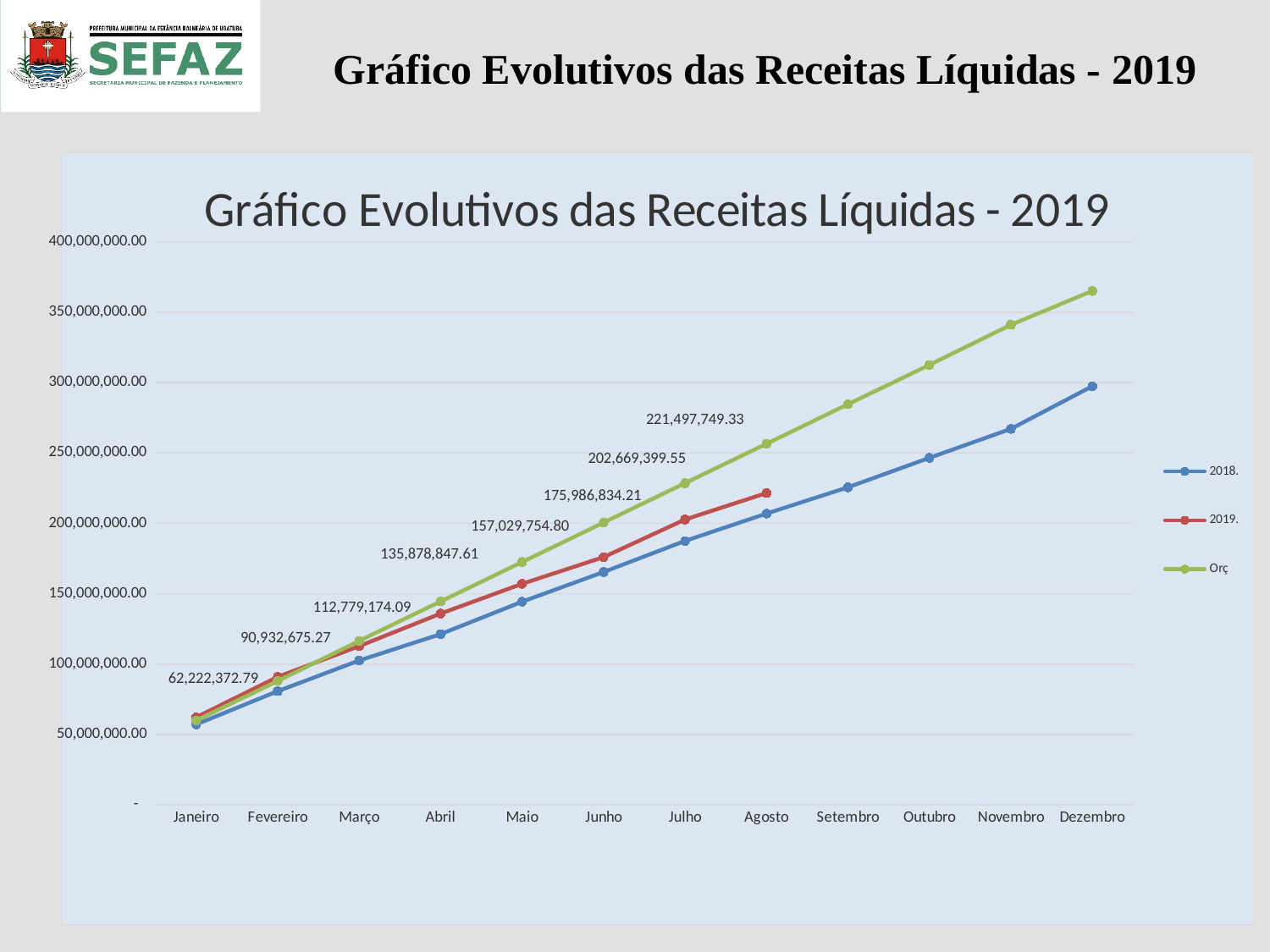
What is the value of the 2019. series for Agosto? 221,497,749.33 Which series has the higher value in Dezembro, 2018. or Orç? Orç What is the value of the 2019. series for Junho? 175,986,834.21 What is the difference between the 2019. values for Fevereiro and Janeiro? 28,710,302.48 How many series does the legend list? 3 Is the value of the Orç series for Dezembro greater or less than 350,000,000.00? greater What type of chart is shown on the slide? Line chart What is the difference between the 2019. values for Agosto and Julho? 18,828,349.78 In which month does the 2019. series reach its highest value? Agosto How many months are shown on the x axis? 12 What is the value of the 2019. series for Janeiro? 62,222,372.79 What is the value of the 2019. series for Abril? 135,878,847.61